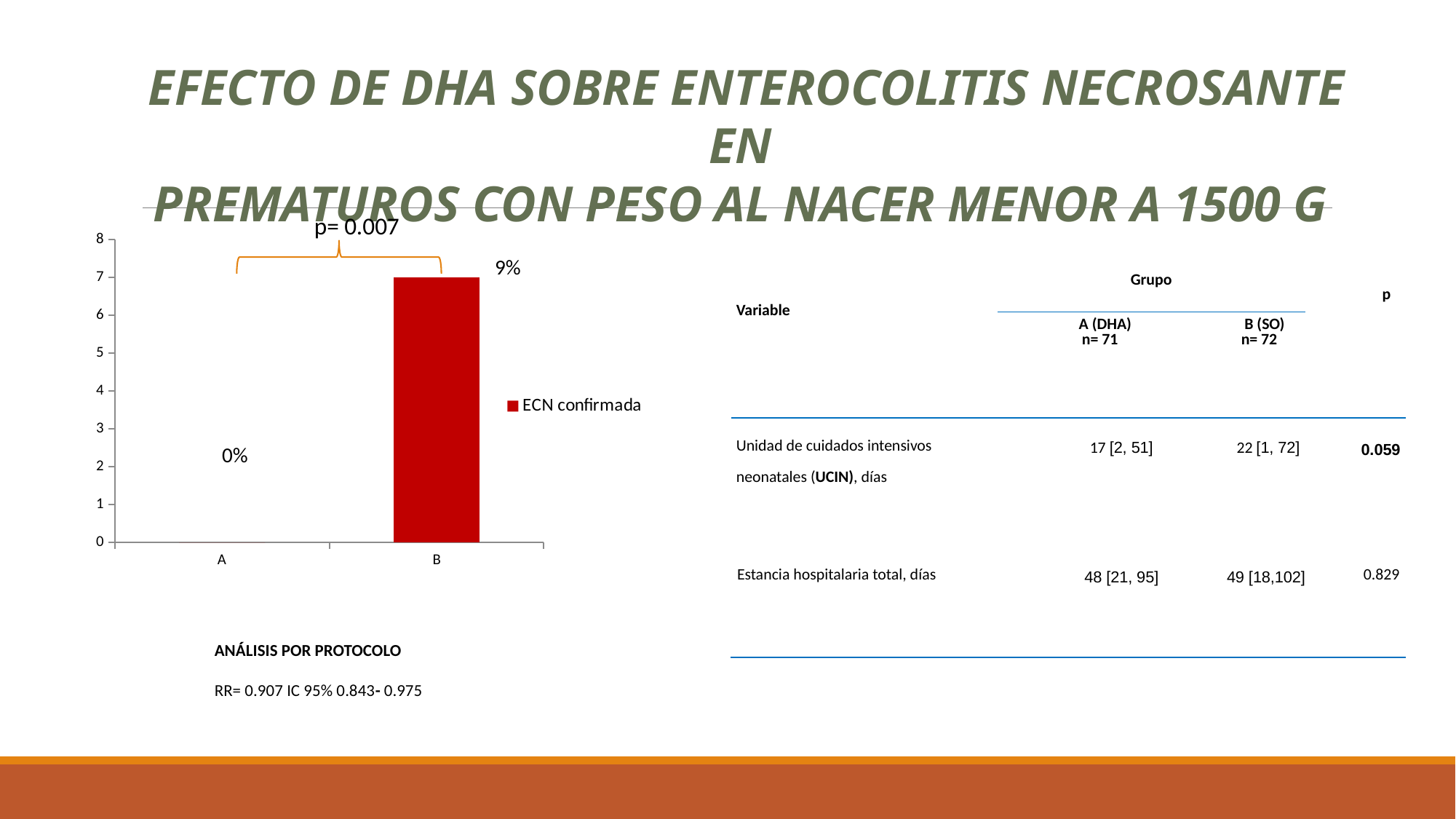
What percentage label is shown for category A? 0% Is the value for B greater or less than 5? greater How many categories are shown on the x axis of the bar chart? 2 What is the name of the series in the bar chart legend? ECN confirmada What kind of chart is shown on the left of the slide? bar chart Which category has the lowest bar in the chart? A What value does the bar for B reach on the y axis? 7 What p-value is shown above the bracket connecting A and B in the chart? p= 0.007 What value does the bar for A reach on the y axis? 0 Which category has the highest bar in the chart? B How many series does the legend of the bar chart list? 1 What percentage label is shown next to the bar for B? 9%